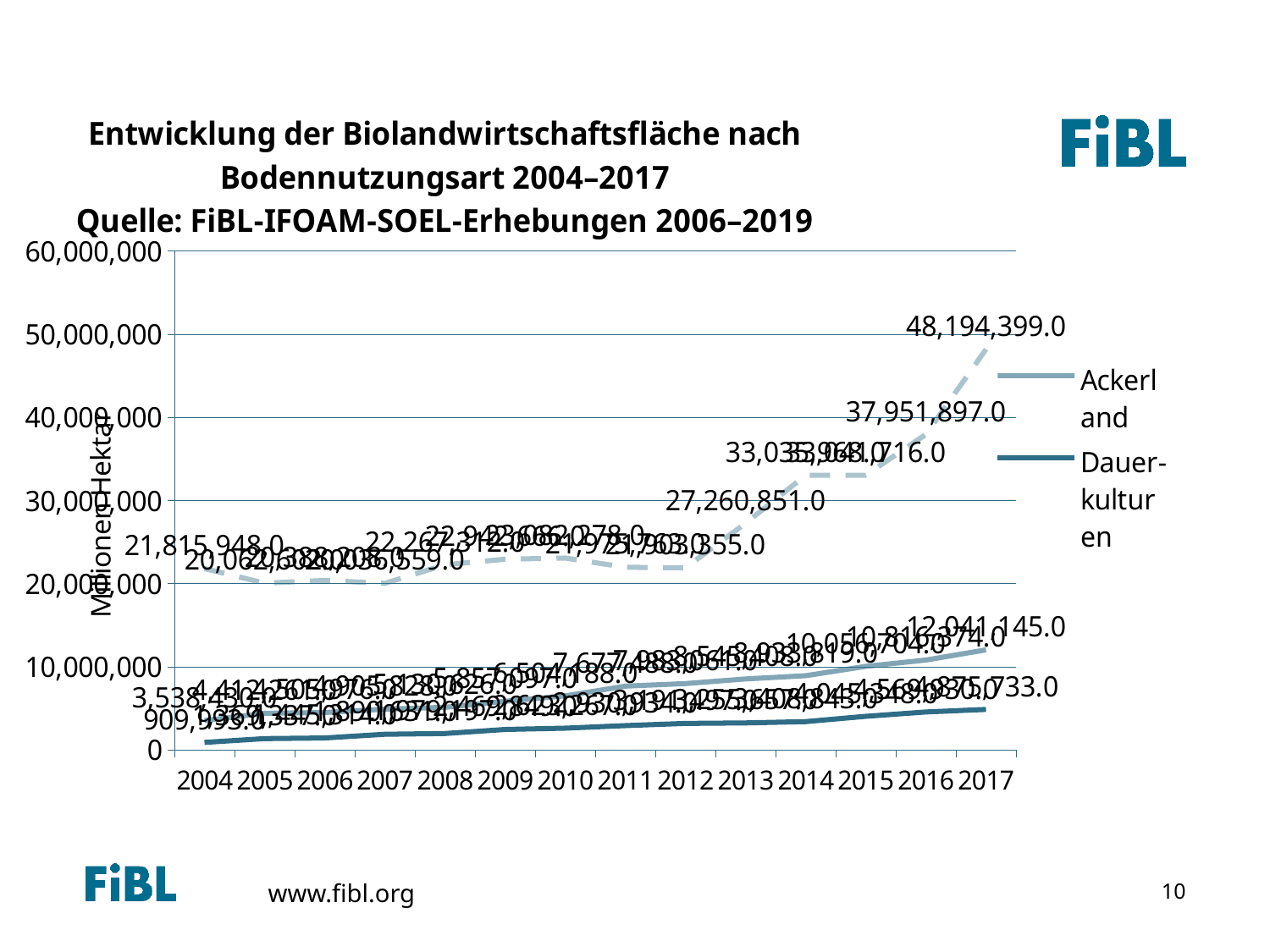
What is the value labelled for Ackerland in 2017? 12,041,145.0 Is the value for Dauerkulturen in 2017 greater or less than 10,000,000? less By how much did the topmost (dashed) line increase from 2016 to 2017? 10,242,502.0 What is the value labelled on the topmost (dashed) line for 2017? 48,194,399.0 What is the value labelled on the topmost (dashed) line for 2013? 27,260,851.0 How many years are shown along the x axis of the chart? 14 What is the value labelled on the topmost (dashed) line for 2016? 37,951,897.0 How many series does the chart's legend list? 2 Which series has the larger value in 2017, Ackerland or Dauerkulturen? Ackerland What is the value labelled on the topmost (dashed) line for 2004? 21,815,948.0 What kind of chart is shown on the slide? line chart In which year does the topmost (dashed) line reach its highest value? 2017